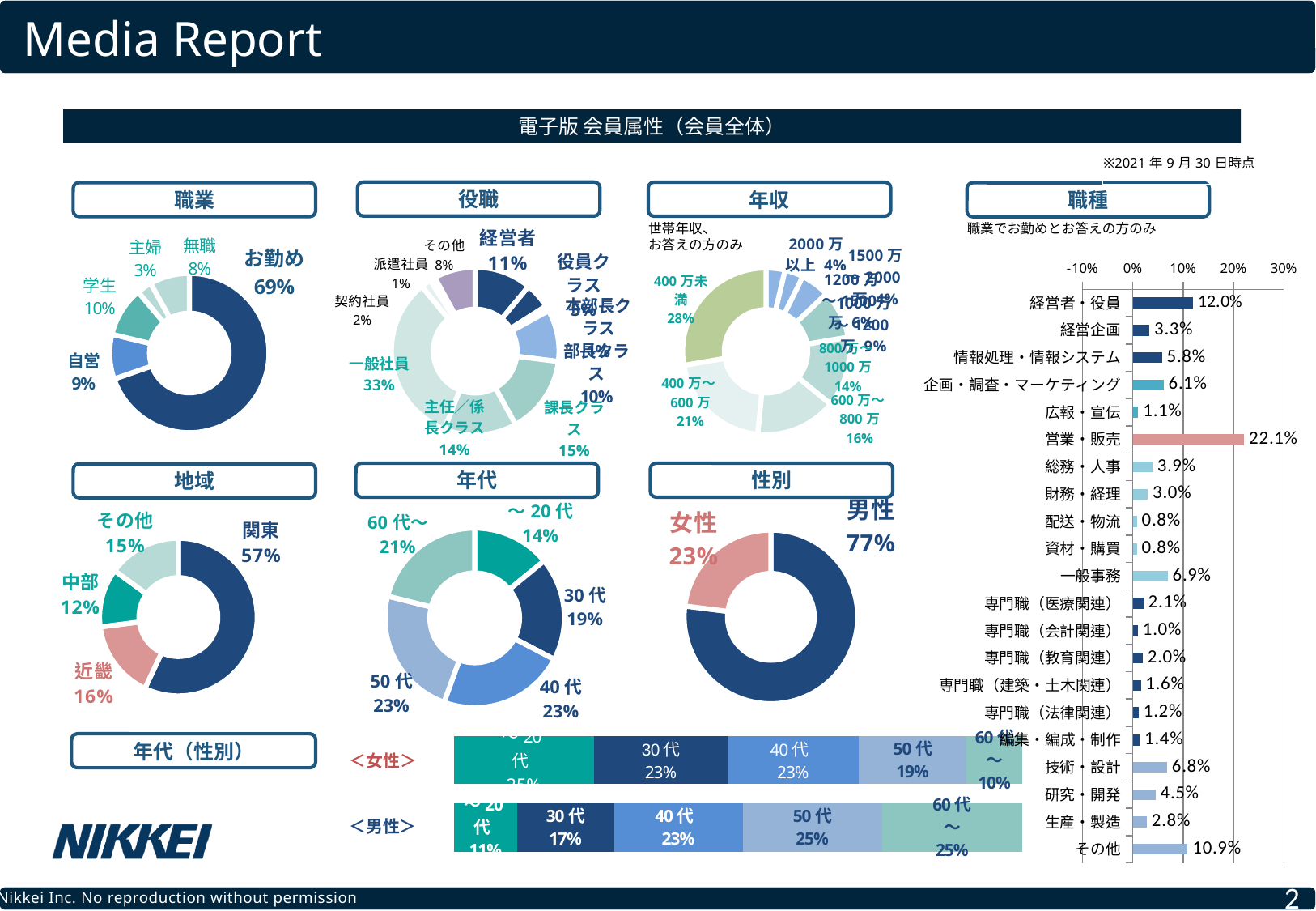
In the 地域 donut chart, what is the difference between 近畿 and 中部? 4% In the 年代（性別） stacked bars, what percentage of 男性 is 50代? 25% In the 年代 donut chart, which is larger, 30代 or 60代〜? 60代〜 In the 職業 donut chart, what percentage is お勤め? 69% In the 職種 bar chart, what is the difference between 営業・販売 and その他? 11.2% In the 役職 donut chart, what percentage is 一般社員? 33% In the 性別 donut chart, what percentage is 男性? 77% In the 年収 donut chart, what percentage is 400万未満? 28% In the 職種 bar chart, which category has the highest value? 営業・販売 What kind of chart is the 職種 chart? bar chart In the 地域 donut chart, what percentage is 関東? 57% In the 職種 bar chart, what is the value for 経営者・役員? 12.0%